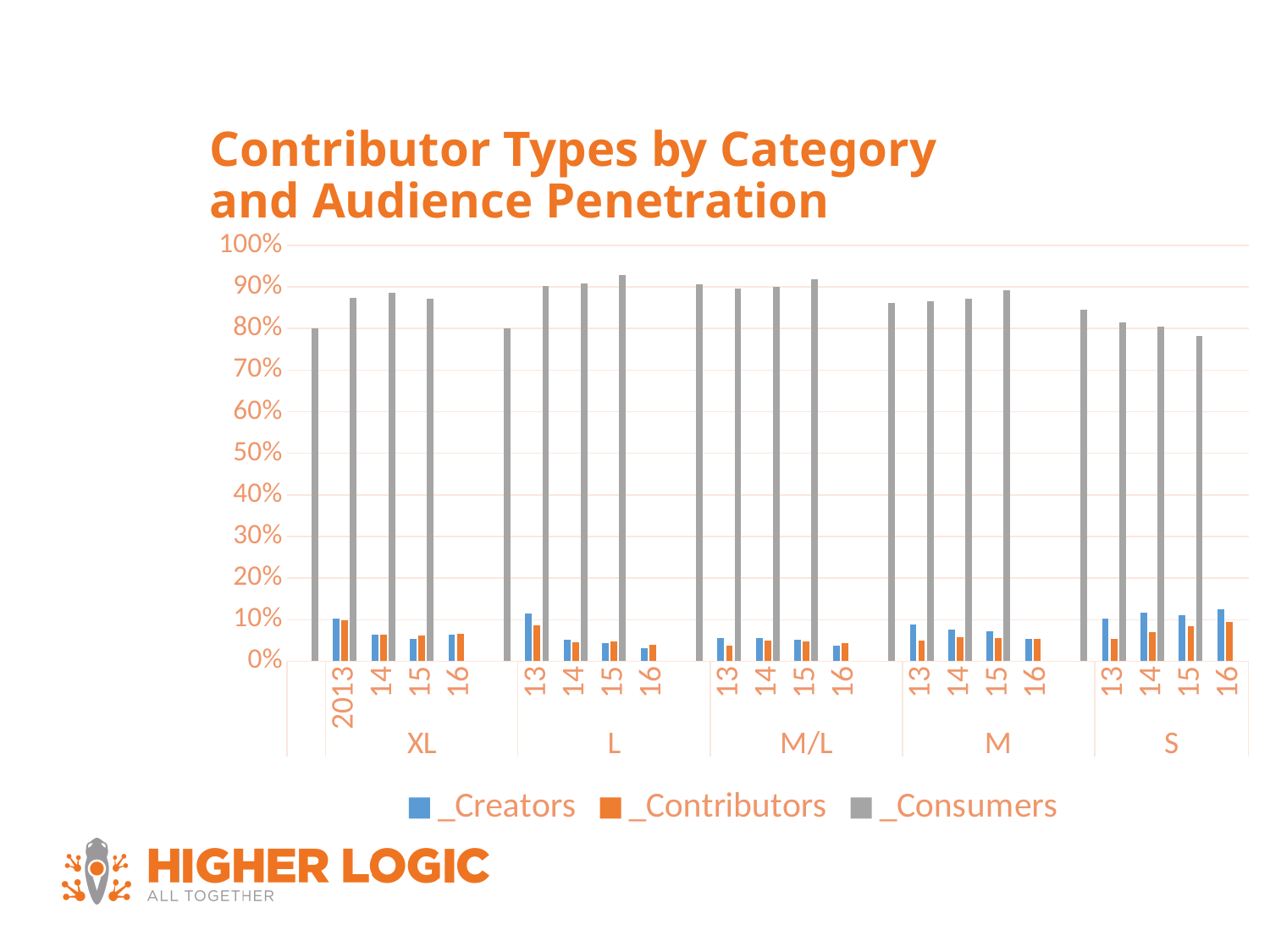
What kind of chart is shown on the slide? bar chart Do the _Consumers values for category S rise or fall from 13 to 16? fall Is the _Consumers value for S in 16 greater or less than 90%? less Which is larger: the _Consumers value for L in 16 or for XL in 2013? L in 16 How many size categories (XL, L, M/L, M, S) are shown along the x axis? 5 How many series does the legend list? 3 Which is larger: the _Creators value for S in 16 or for L in 16? S in 16 Which colour represents the _Consumers series? grey Is the _Consumers value for XL in 2013 greater or less than 90%? less How many years are shown within each size category? 4 Is the _Creators value for L in 16 greater or less than 10%? less